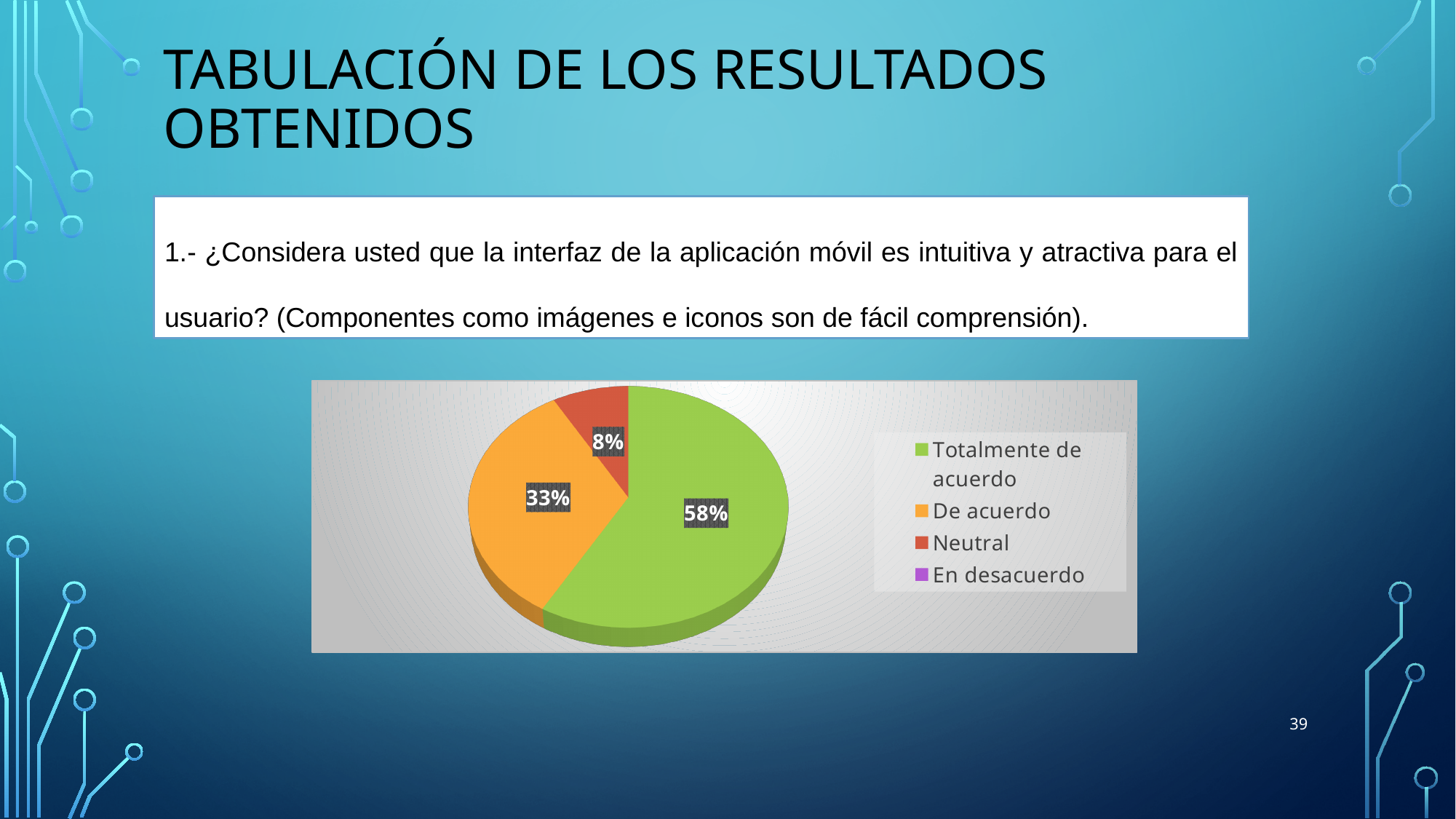
How many entries does the legend list? 4 Which category has the largest slice of the pie? Totalmente de acuerdo What kind of chart is shown on the slide? pie chart What is the difference between the "Totalmente de acuerdo" and "De acuerdo" shares? 25% Which labelled slice of the pie is the smallest? Neutral What share of the pie does "Neutral" have? 8% What colour is the "Totalmente de acuerdo" slice? green What share of the pie does "Totalmente de acuerdo" have? 58% What is the difference between the "De acuerdo" and "Neutral" shares? 25% What share of the pie does "De acuerdo" have? 33% Which is larger, the "De acuerdo" slice or the "Neutral" slice? De acuerdo Which legend entry is shown in orange? De acuerdo